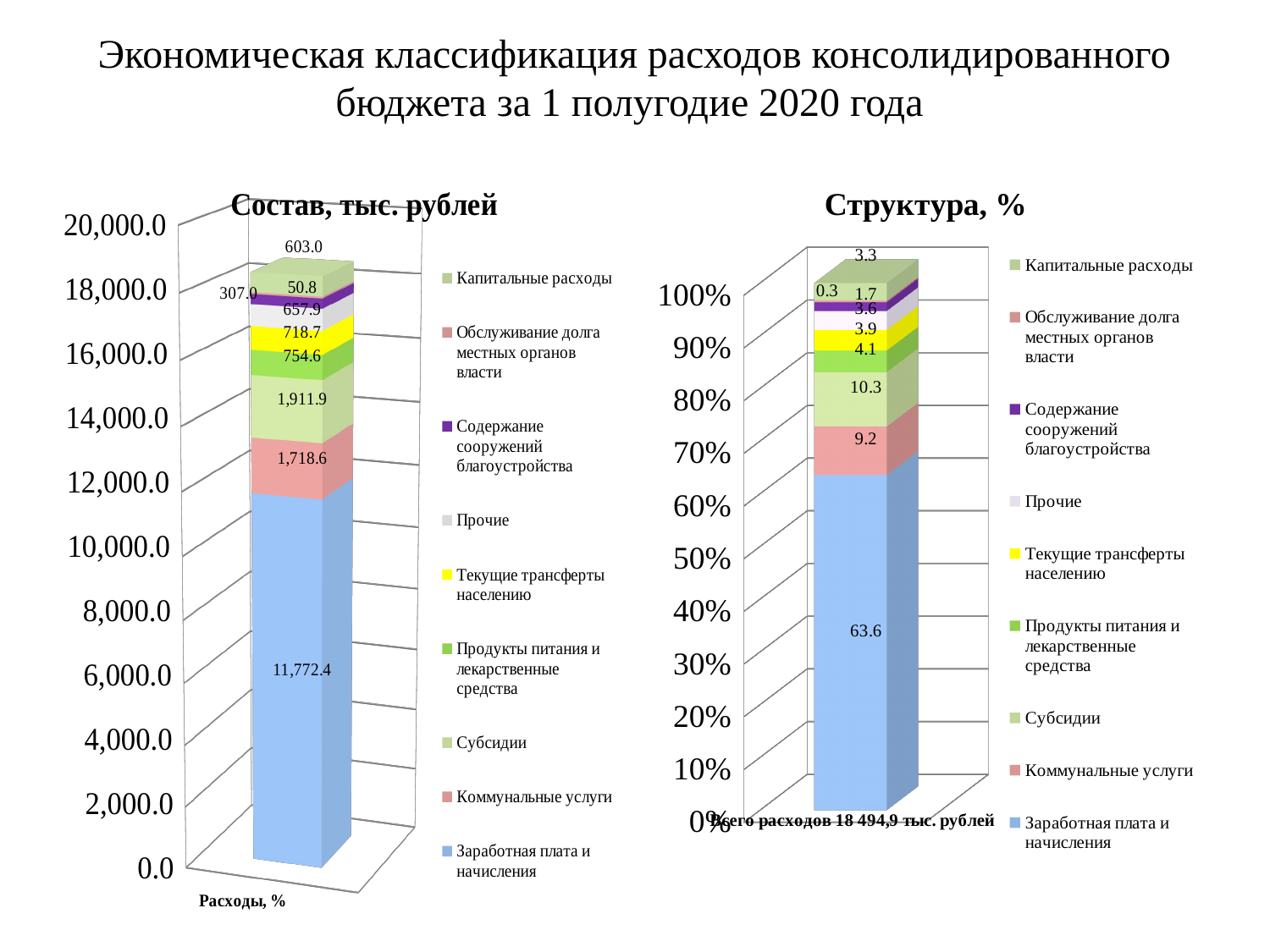
In the chart titled "Структура, %", which is larger: Продукты питания и лекарственные средства or Текущие трансферты населению? Продукты питания и лекарственные средства In the chart titled "Состав, тыс. рублей", which series has the smallest value? Обслуживание долга местных органов власти In the chart titled "Состав, тыс. рублей", what is the difference between Субсидии and Коммунальные услуги? 193.3 In the chart titled "Состав, тыс. рублей", which series has the largest value? Заработная плата и начисления In the chart titled "Состав, тыс. рублей", what is the value for Заработная плата и начисления? 11,772.4 According to the text below the chart titled "Структура, %", what is the total of all expenditures? 18 494,9 тыс. рублей In the chart titled "Состав, тыс. рублей", what is the value for Субсидии? 1,911.9 In the chart titled "Структура, %", what is the value for Коммунальные услуги? 9.2 How many series does the legend of the chart titled "Структура, %" list? 9 In the chart titled "Структура, %", what is the value for Обслуживание долга местных органов власти? 0.3 In the chart titled "Состав, тыс. рублей", what is the value for Капитальные расходы? 603.0 What kind of chart is the chart titled "Состав, тыс. рублей"? Stacked bar chart